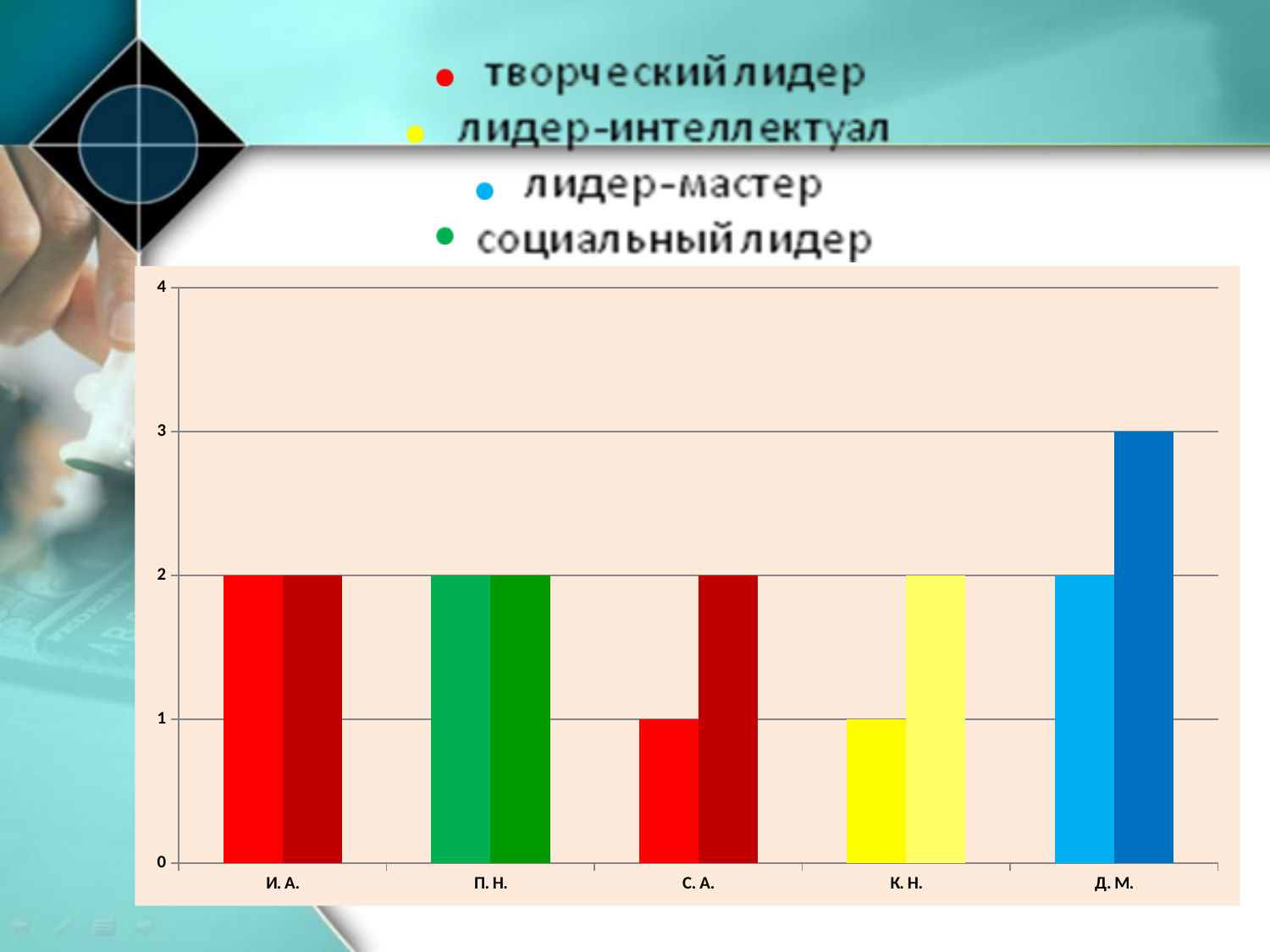
What is the value of the left (lighter) bar for С. А.? 1 Which legend entry is marked with a green dot? социальный лидер How many categories are shown on the x axis of the chart? 5 What is the value of the right (darker) bar for Д. М.? 3 Which category has the tallest bar in the chart? Д. М. What is the value of the left bar for П. Н.? 2 What is the value of the right (darker) bar for К. Н.? 2 What kind of chart is shown on the slide? bar chart What is the difference between the right bar and the left bar for Д. М.? 1 How many entries does the legend above the chart list? 4 Which is larger: the left bar for К. Н. or the left bar for И. А.? И. А. Is the value of the right bar for Д. М. greater or less than 2? greater